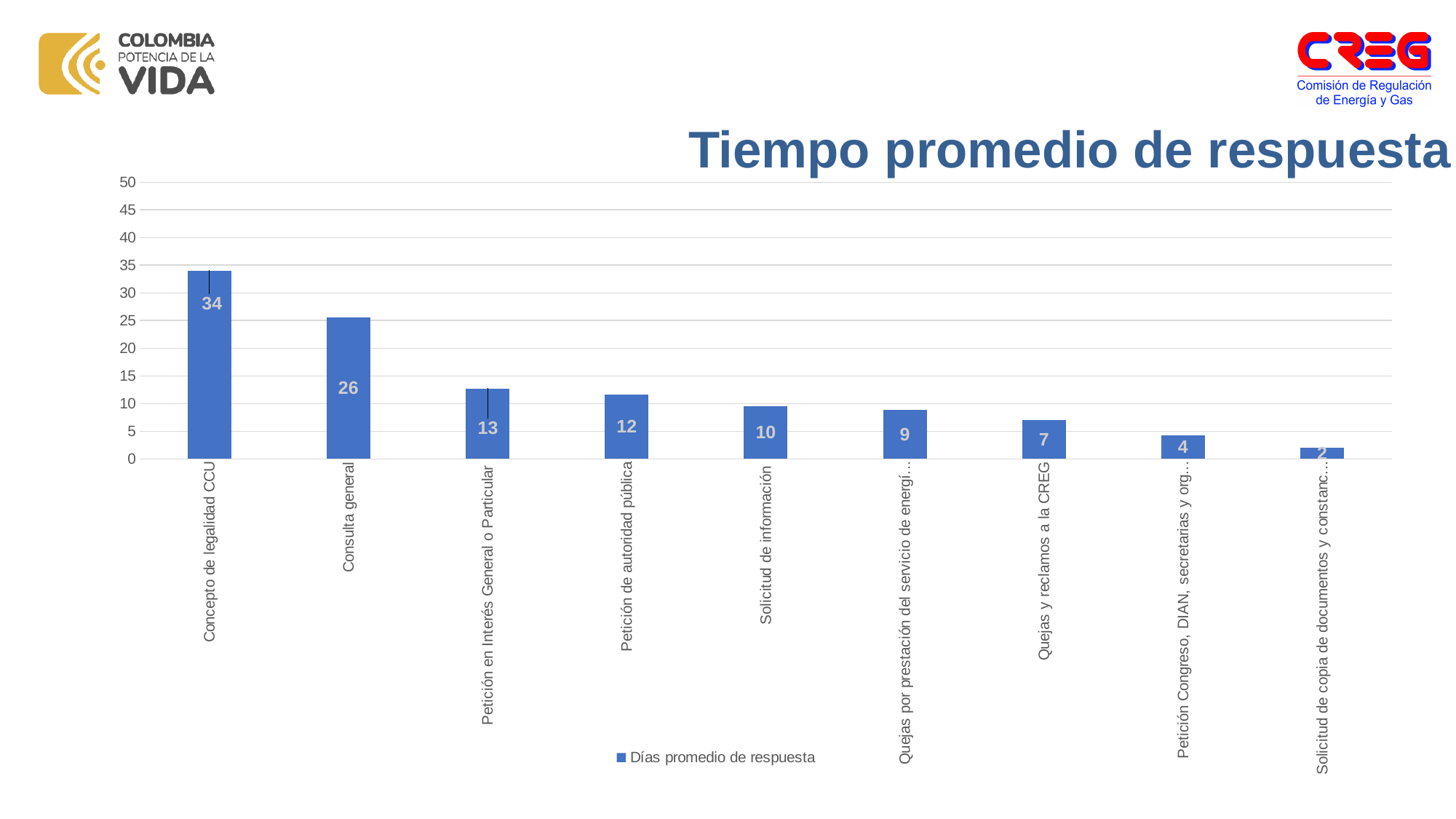
What is the difference between the values for Concepto de legalidad CCU and Consulta general? 8 What is the value shown for Petición en Interés General o Particular? 13 Is the value for Consulta general greater or less than 20? greater Which is larger, the value for Petición de autoridad pública or the value for Solicitud de información? Petición de autoridad pública What series name does the legend show? Días promedio de respuesta What is the value shown for Consulta general? 26 What is the value shown for Solicitud de información? 10 What is the average response time in days for Concepto de legalidad CCU? 34 What is the value shown for Quejas y reclamos a la CREG? 7 How many categories are shown on the x axis? 9 What type of chart is shown on the slide? Bar chart Which category has the highest average response time? Concepto de legalidad CCU